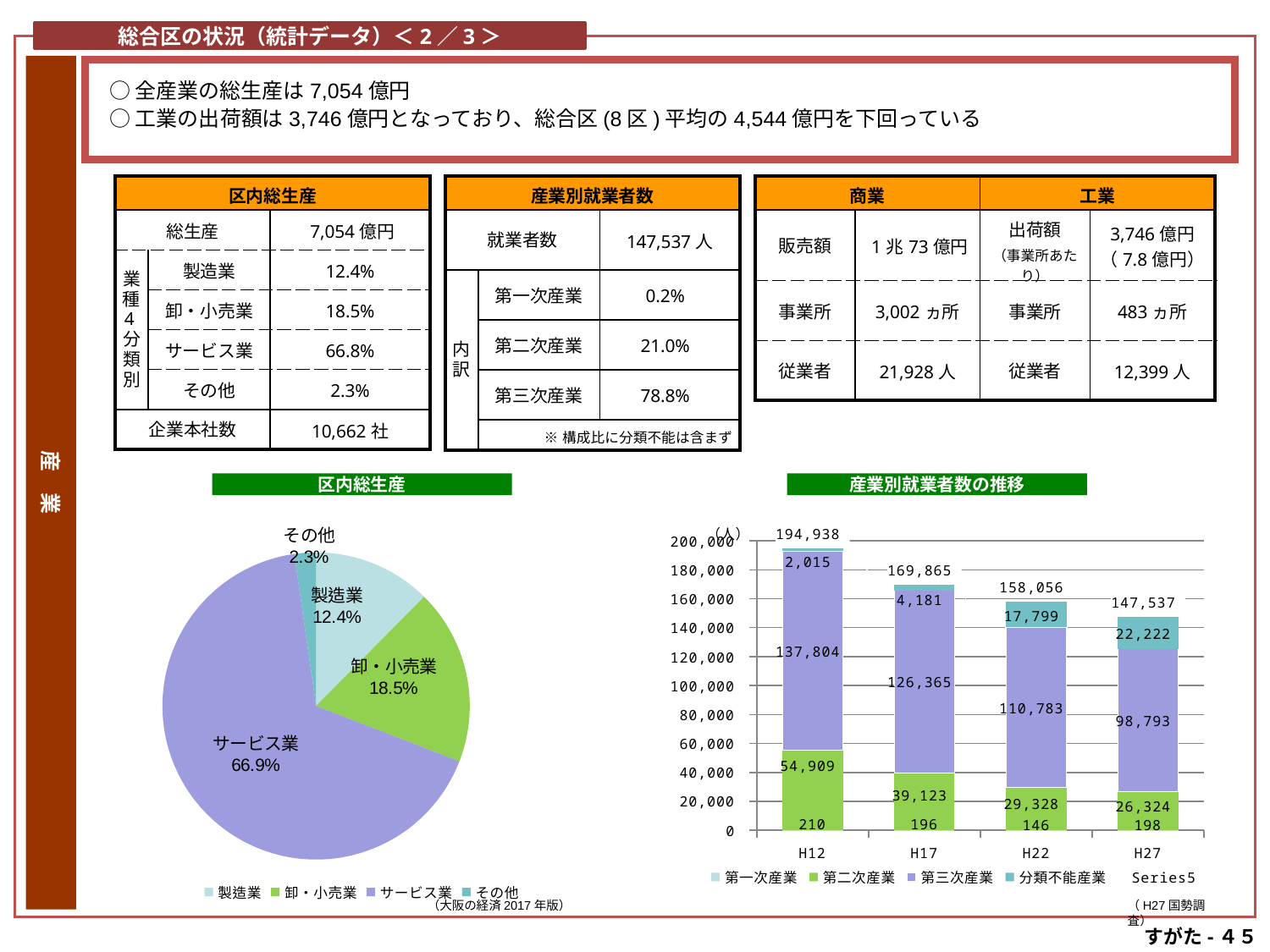
In the 産業別就業者数の推移 chart, what is the total for H22? 158,056 In the 産業別就業者数の推移 chart, what is the value of 分類不能産業 for H27? 22,222 In the 産業別就業者数の推移 chart, how many year categories are shown on the x axis? 4 In the 区内総生産 pie chart, how many categories are shown? 4 In the 区内総生産 pie chart, what share does サービス業 have? 66.9% In the 区内総生産 pie chart, which category has the smallest slice? その他 In the 区内総生産 pie chart, which category has the largest slice? サービス業 In the 産業別就業者数の推移 chart, what is the value of 第三次産業 for H12? 137,804 In the 区内総生産 pie chart, what is the difference between the shares of 卸・小売業 and 製造業? 6.1% In the 産業別就業者数の推移 chart, which is larger: 第二次産業 in H12 or 第二次産業 in H17? H12 In the 産業別就業者数の推移 chart, do the bar totals rise or fall from H12 to H27? Fall What kind of chart is the 産業別就業者数の推移 chart? Stacked bar chart